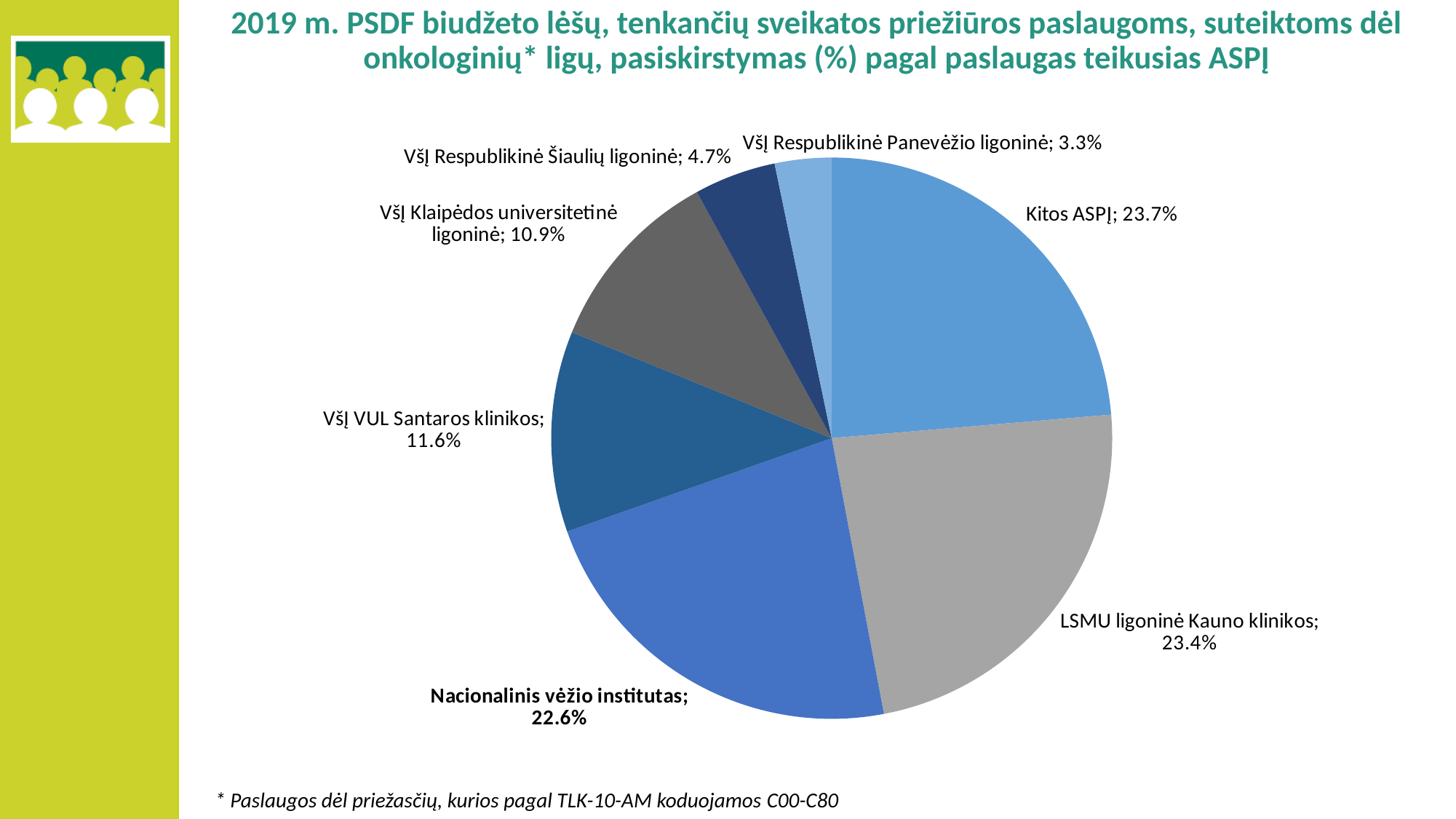
What is the value shown for VšĮ VUL Santaros klinikos? 11.6% Which category has the smallest slice of the pie? VšĮ Respublikinė Panevėžio ligoninė What is the value shown for VšĮ Respublikinė Šiaulių ligoninė? 4.7% What kind of chart is shown on the slide? pie chart How many slices does the pie chart have? 7 Which is larger: the share for LSMU ligoninė Kauno klinikos or the share for VšĮ VUL Santaros klinikos? LSMU ligoninė Kauno klinikos Which year does the chart title refer to? 2019 Which category has the largest slice of the pie? Kitos ASPĮ What is the difference in percentage points between VšĮ VUL Santaros klinikos and VšĮ Respublikinė Panevėžio ligoninė? 8.3 What is the value shown for VšĮ Klaipėdos universitetinė ligoninė? 10.9% What share of the pie does Nacionalinis vėžio institutas have? 22.6% What is the difference in percentage points between Kitos ASPĮ and Nacionalinis vėžio institutas? 1.1